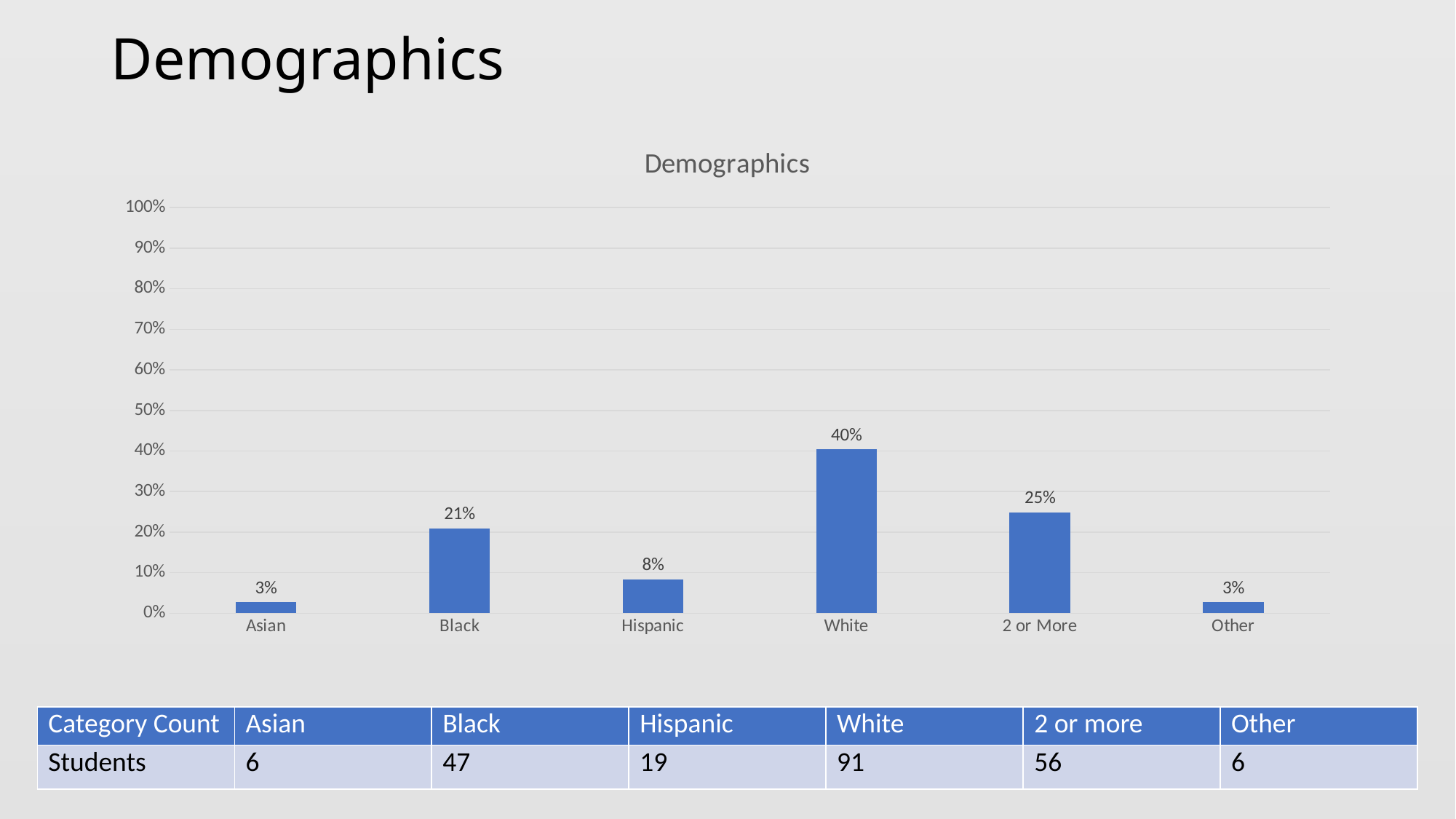
What is the difference between the values for White and 2 or More in the Demographics chart? 15% Which is larger in the Demographics chart, the value for Black or the value for 2 or More? 2 or More How many categories are shown in the Demographics chart? 6 What is the difference between the values for Black and Hispanic in the Demographics chart? 13% What is the value for Hispanic in the Demographics chart? 8% What kind of chart is the Demographics chart? bar chart Is the value for White in the Demographics chart greater or less than 50%? less What is the title of the chart on the slide? Demographics Which category has the highest value in the Demographics chart? White What is the value for White in the Demographics chart? 40% What is the value for 2 or More in the Demographics chart? 25% What is the value for Black in the Demographics chart? 21%